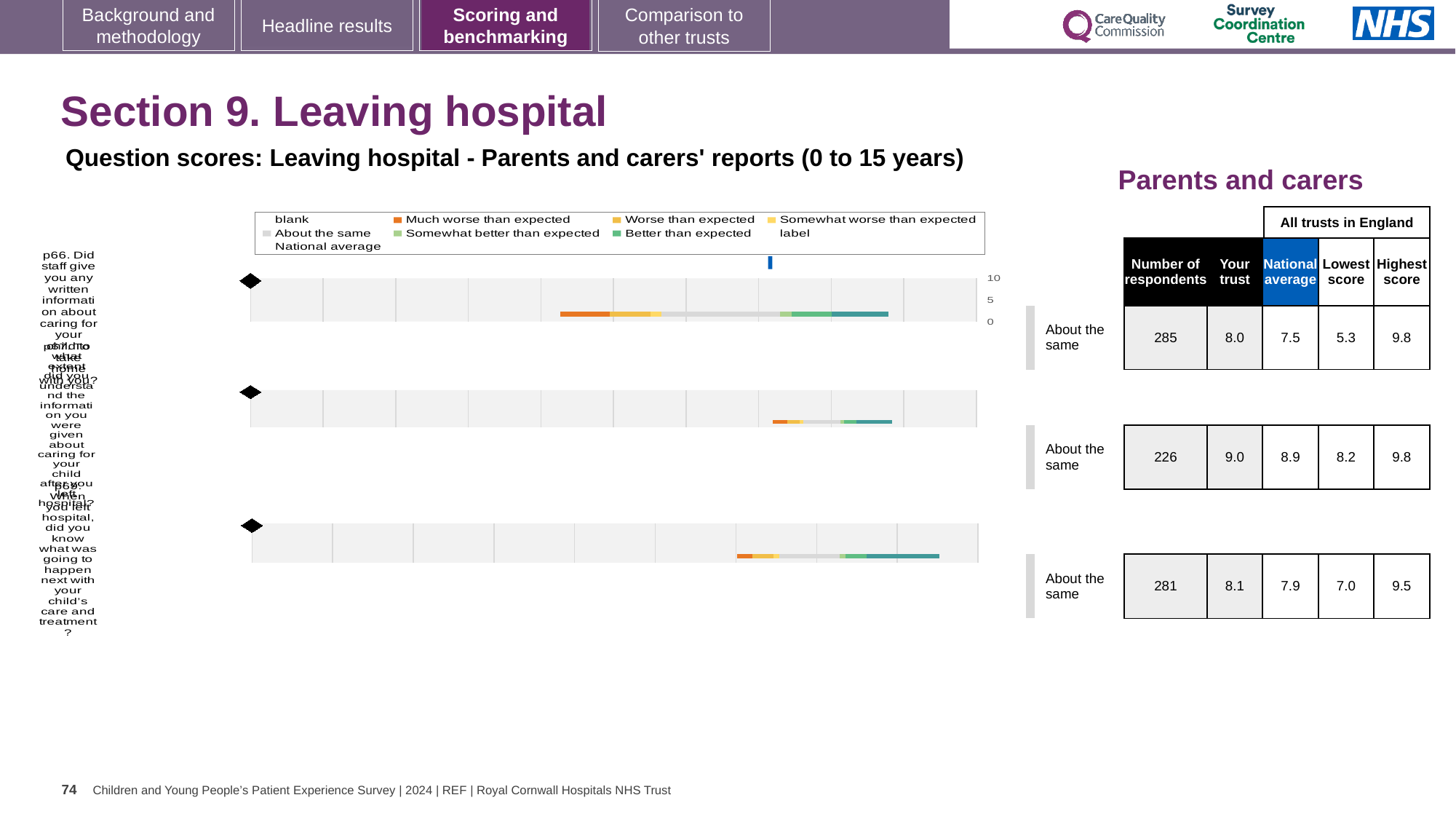
In the table, what is the national average for the second row (226 respondents)? 8.9 In the table, what is the lowest score for the first row (285 respondents)? 5.3 What benchmark category is shown next to each of the three charts? About the same Which row of the table has the lowest 'Lowest score' value? The first row, 5.3 For the second row (226 respondents), which is larger: the 'Your trust' score or the national average? Your trust For the first row (285 respondents), how much higher is the 'Your trust' score than the national average? 0.5 How many question charts are shown on the slide? 3 For the third row (281 respondents), what is the difference between the highest score and the lowest score? 2.5 Which row of the table has the highest number of respondents? The first row, 285 In the table, what is the 'Your trust' score for the first row (285 respondents)? 8.0 What kind of chart is used to show the benchmarking results for each question on this slide? Bar chart In the table, what is the highest score for the third row (281 respondents)? 9.5